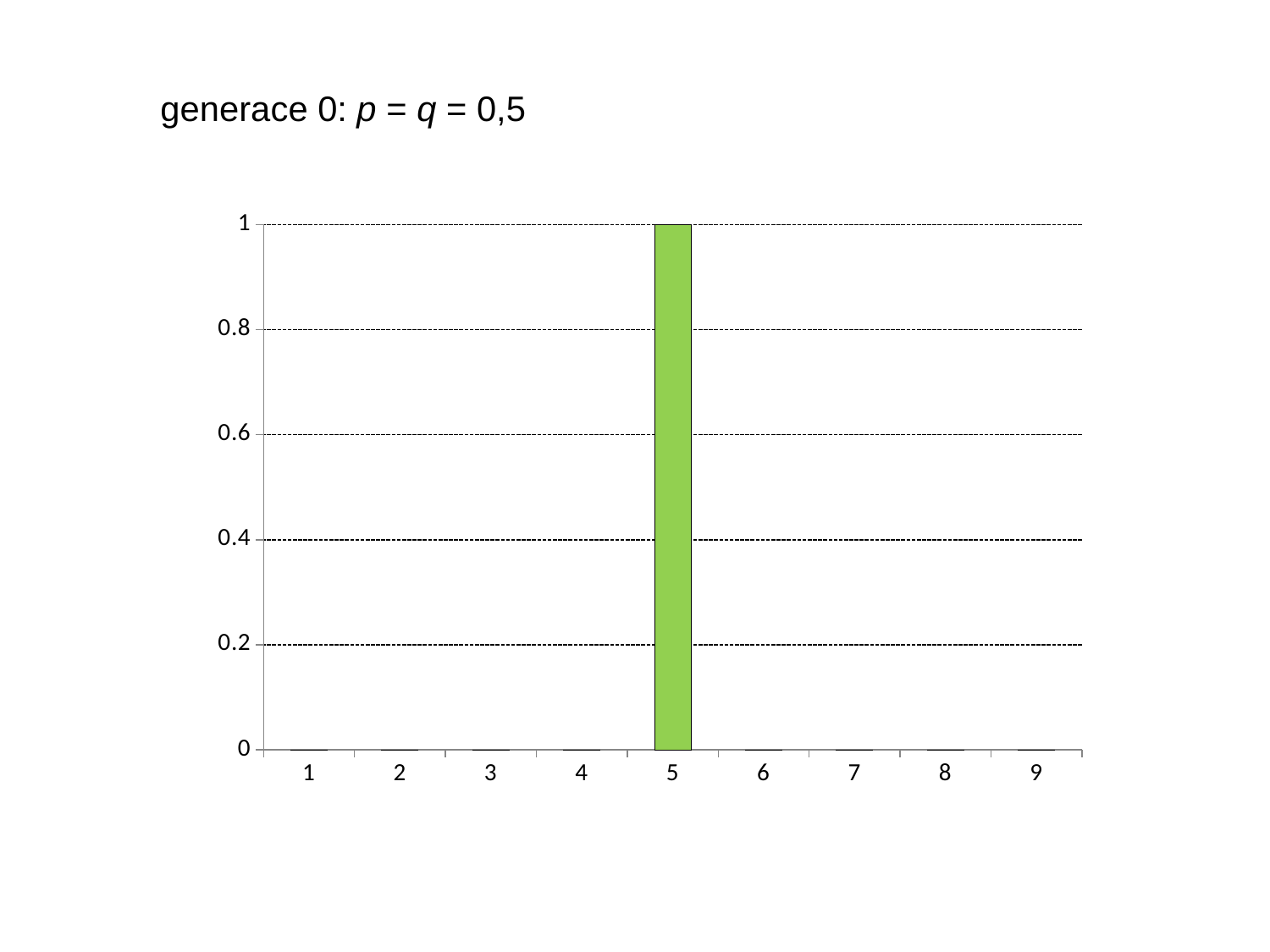
What colour is the bar for category 5? green What is the value for category 3? 0 What is the difference between the value for category 5 and the value for category 1? 1 What kind of chart is shown on the slide? bar chart Which category has the highest value? 5 How many categories are shown on the x axis? 9 What is the highest value shown on the y axis? 1 Is the value for category 5 greater or less than 0.8? greater What is the value for category 5? 1 Which is larger, the value for category 5 or the value for category 6? category 5 Is the value for category 7 greater or less than 0.2? less How many categories have a visible non-zero bar? 1